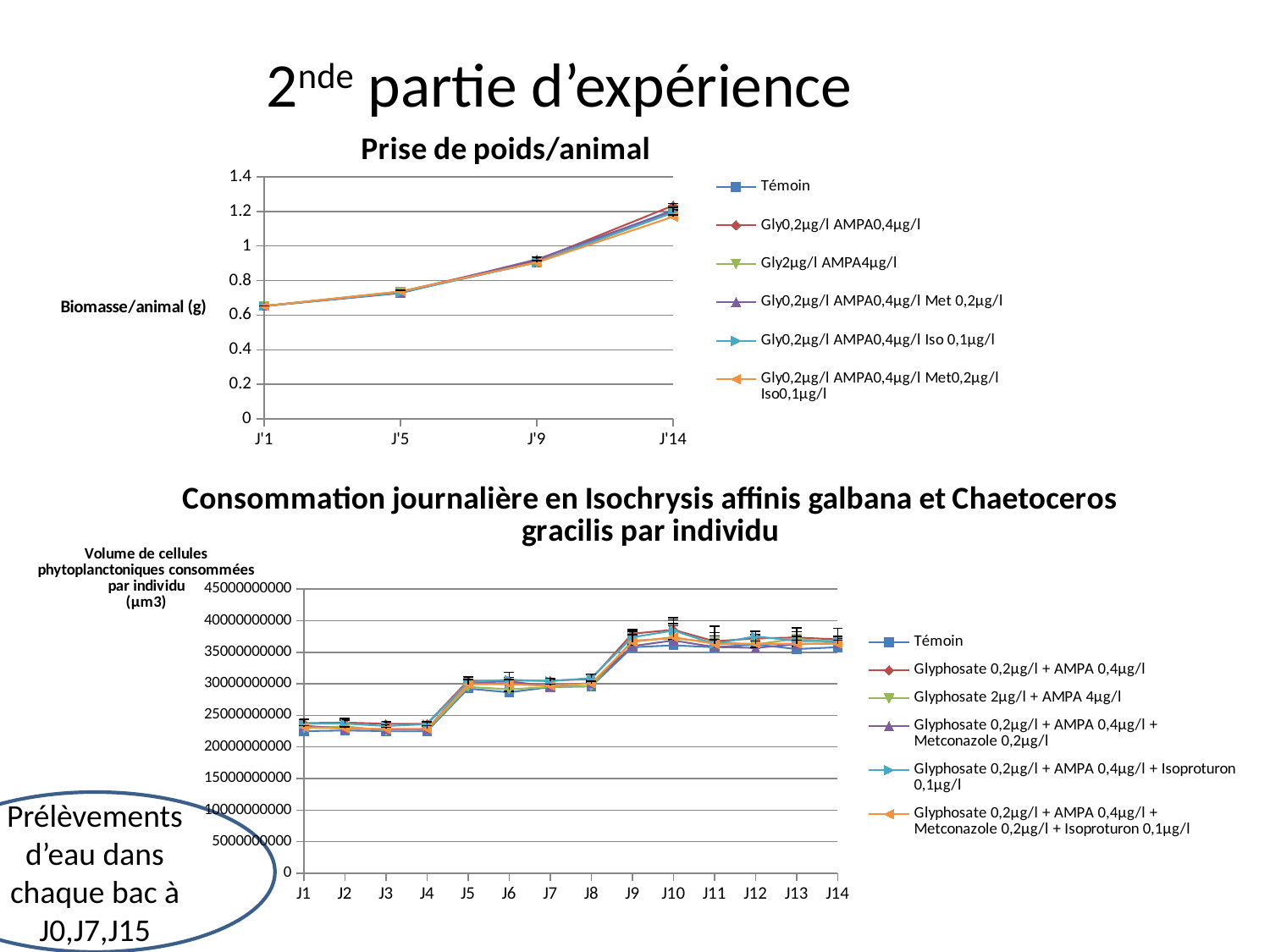
What kind of chart is the 'Consommation journalière en Isochrysis affinis galbana et Chaetoceros gracilis par individu' chart? line chart In the 'Consommation journalière' chart, is the value for Témoin at J10 greater or less than 30000000000? greater In the 'Prise de poids/animal' chart, is the value for Témoin at J'14 greater or less than 1? greater What is the y-axis label of the 'Prise de poids/animal' chart? Biomasse/animal (g) How many series does the legend of the 'Prise de poids/animal' chart list? 6 What kind of chart is the 'Prise de poids/animal' chart? line chart How many points are on the x axis of the 'Consommation journalière' chart? 14 In the 'Consommation journalière' chart, is the value for Témoin at J1 greater or less than 25000000000? less In the 'Prise de poids/animal' chart, do the values rise or fall from J'1 to J'14? rise How many series does the legend of the 'Consommation journalière' chart list? 6 How many points are on the x axis of the 'Prise de poids/animal' chart? 4